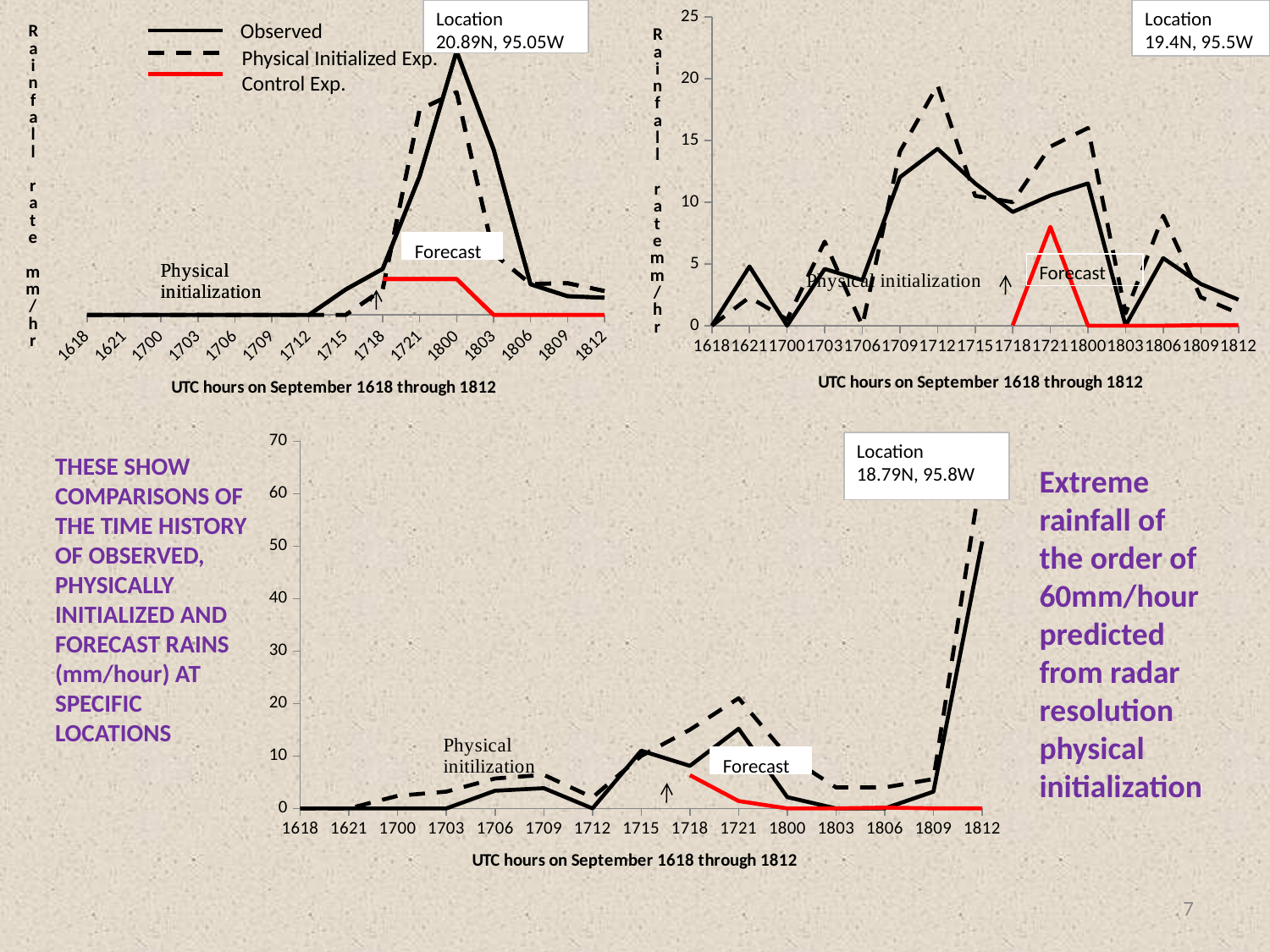
How many series does the legend on the slide list? 3 In the top-right chart (Location 19.4N, 95.5W), which is larger at 1712: the Observed value or the Physical Initialized Exp. value? Physical Initialized Exp. What is the x-axis title of the bottom chart (Location 18.79N, 95.8W)? UTC hours on September 1618 through 1812 In the bottom chart (Location 18.79N, 95.8W), how many UTC hour points are shown on the x axis? 15 In the top-right chart (Location 19.4N, 95.5W), is the Observed value at 1712 greater or less than 10? greater In the bottom chart (Location 18.79N, 95.8W), does the Observed series rise or fall from 1809 to 1812? rise In the bottom chart (Location 18.79N, 95.8W), at which UTC hour does the Observed series reach its highest value? 1812 In the top-right chart (Location 19.4N, 95.5W), is the Physical Initialized Exp. value at 1712 greater or less than 15? greater In the top-right chart (Location 19.4N, 95.5W), at which UTC hour does the Physical Initialized Exp. series reach its highest value? 1712 In the bottom chart (Location 18.79N, 95.8W), is the Physical Initialized Exp. value at 1721 greater or less than 10? greater What kind of chart is the bottom chart (Location 18.79N, 95.8W)? line chart